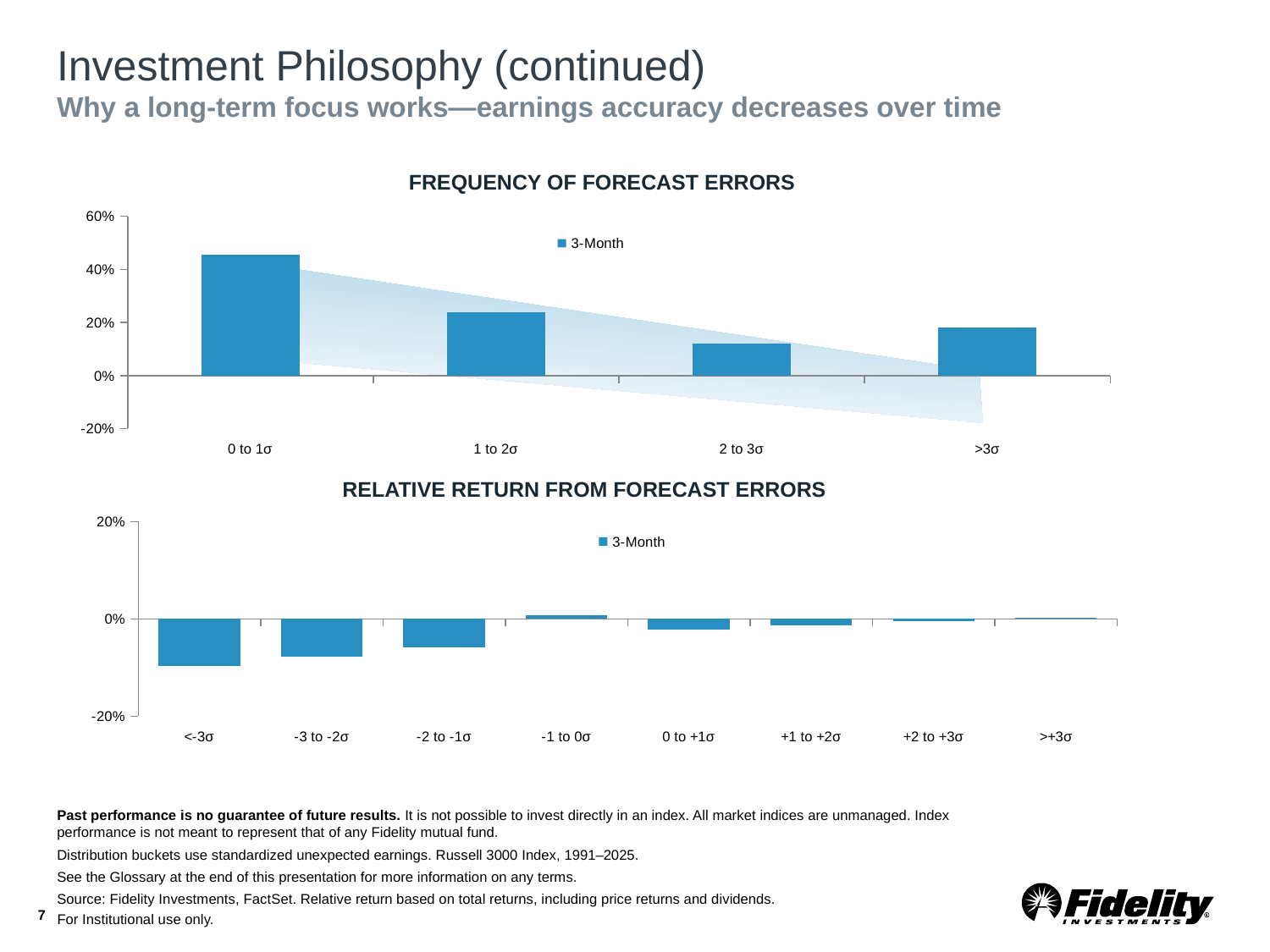
In the FREQUENCY OF FORECAST ERRORS chart, which category has the highest value? 0 to 1σ What kind of chart is the FREQUENCY OF FORECAST ERRORS chart? Bar chart How many categories are shown on the x axis of the FREQUENCY OF FORECAST ERRORS chart? 4 In the RELATIVE RETURN FROM FORECAST ERRORS chart, is the value for -3 to -2σ greater or less than 0%? less In the FREQUENCY OF FORECAST ERRORS chart, which category has the lowest value? 2 to 3σ How many series does the legend of the RELATIVE RETURN FROM FORECAST ERRORS chart list? 1 In the FREQUENCY OF FORECAST ERRORS chart, is the value for 0 to 1σ greater or less than 40%? greater How many categories are shown on the x axis of the RELATIVE RETURN FROM FORECAST ERRORS chart? 8 In the FREQUENCY OF FORECAST ERRORS chart, which is larger, the value for 1 to 2σ or the value for >3σ? 1 to 2σ What is the name of the series shown in the legend of the FREQUENCY OF FORECAST ERRORS chart? 3-Month In the FREQUENCY OF FORECAST ERRORS chart, is the value for 2 to 3σ greater or less than 20%? less In the RELATIVE RETURN FROM FORECAST ERRORS chart, which category has the lowest value? <-3σ